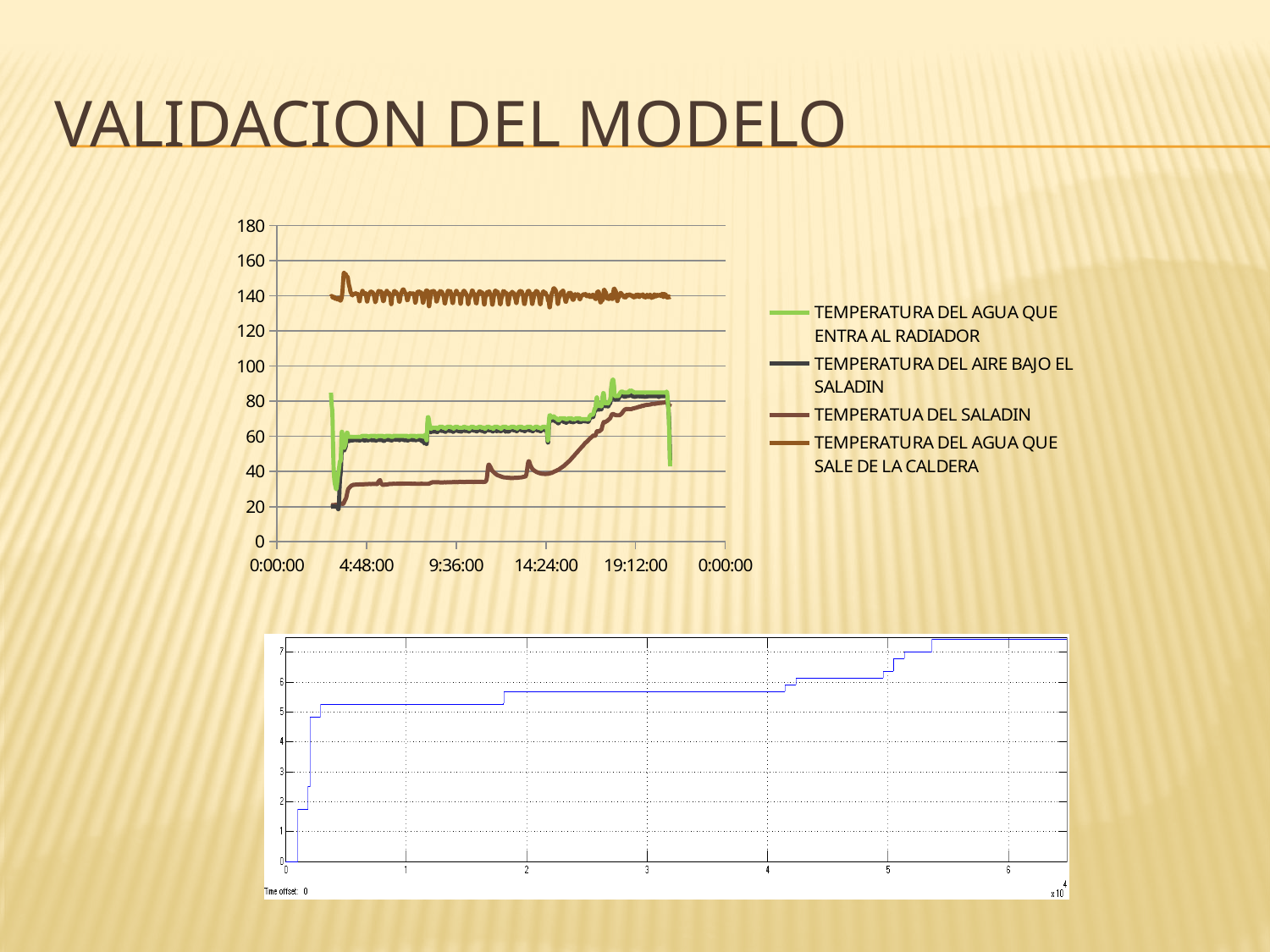
In the top chart, is the value for TEMPERATURA DEL AGUA QUE SALE DE LA CALDERA at 9:36:00 greater or less than 120? greater In the top chart, does the TEMPERATUA DEL SALADIN series generally rise or fall from 4:48:00 to 19:12:00? rise In the top chart, which series has the highest values throughout the plotted period? TEMPERATURA DEL AGUA QUE SALE DE LA CALDERA What kind of chart is the bottom chart on the slide? line chart How many series does the legend of the top chart list? 4 In the bottom chart, is the value at x = 1 greater or less than 6? less In the top chart, is the value for TEMPERATUA DEL SALADIN at 9:36:00 greater or less than 40? less What kind of chart is the top chart on the slide? line chart In the bottom chart, does the plotted line rise or fall along the x axis? rise What is the highest value shown on the y axis of the top chart? 180 In the top chart, at 14:24:00, which is larger: TEMPERATURA DEL AGUA QUE ENTRA AL RADIADOR or TEMPERATUA DEL SALADIN? TEMPERATURA DEL AGUA QUE ENTRA AL RADIADOR